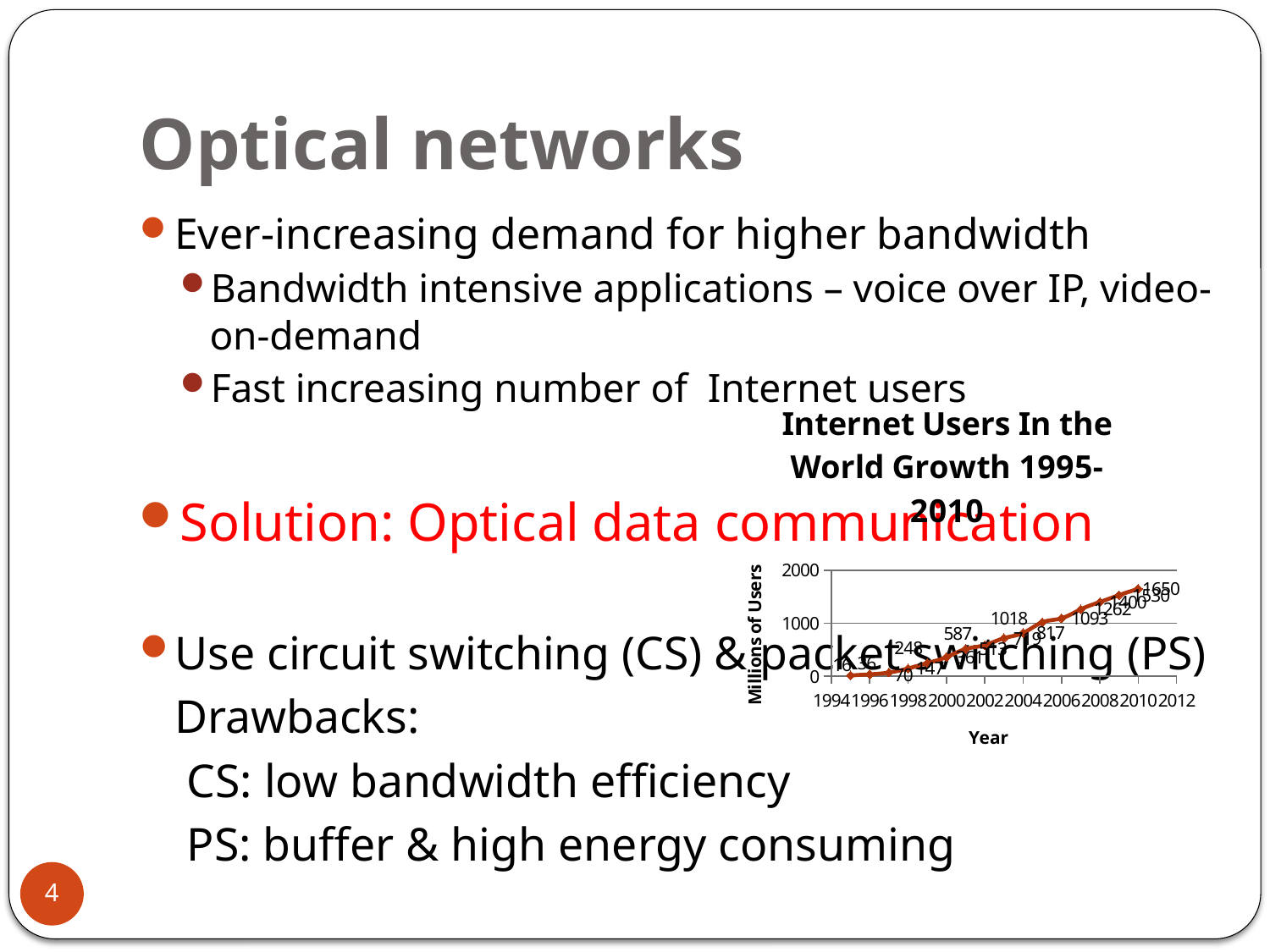
Is the value for 2008 greater or less than 1000? greater What is the value for 2010 on the chart? 1650 What is the value for 1995 on the chart? 16 What is the lowest value plotted on the chart? 16 Do the values rise or fall from 1995 to 2010? rise What is the difference between the value for 2010 and the value for 1995? 1634 What is the label of the vertical axis of the chart? Millions of Users Which year has the larger value, 1995 or 2010? 2010 Is the value for 2000 greater or less than 1000? less What is the title of the chart? Internet Users In the World Growth 1995-2010 What kind of chart is shown on the slide? line chart What is the highest value plotted on the chart? 1650